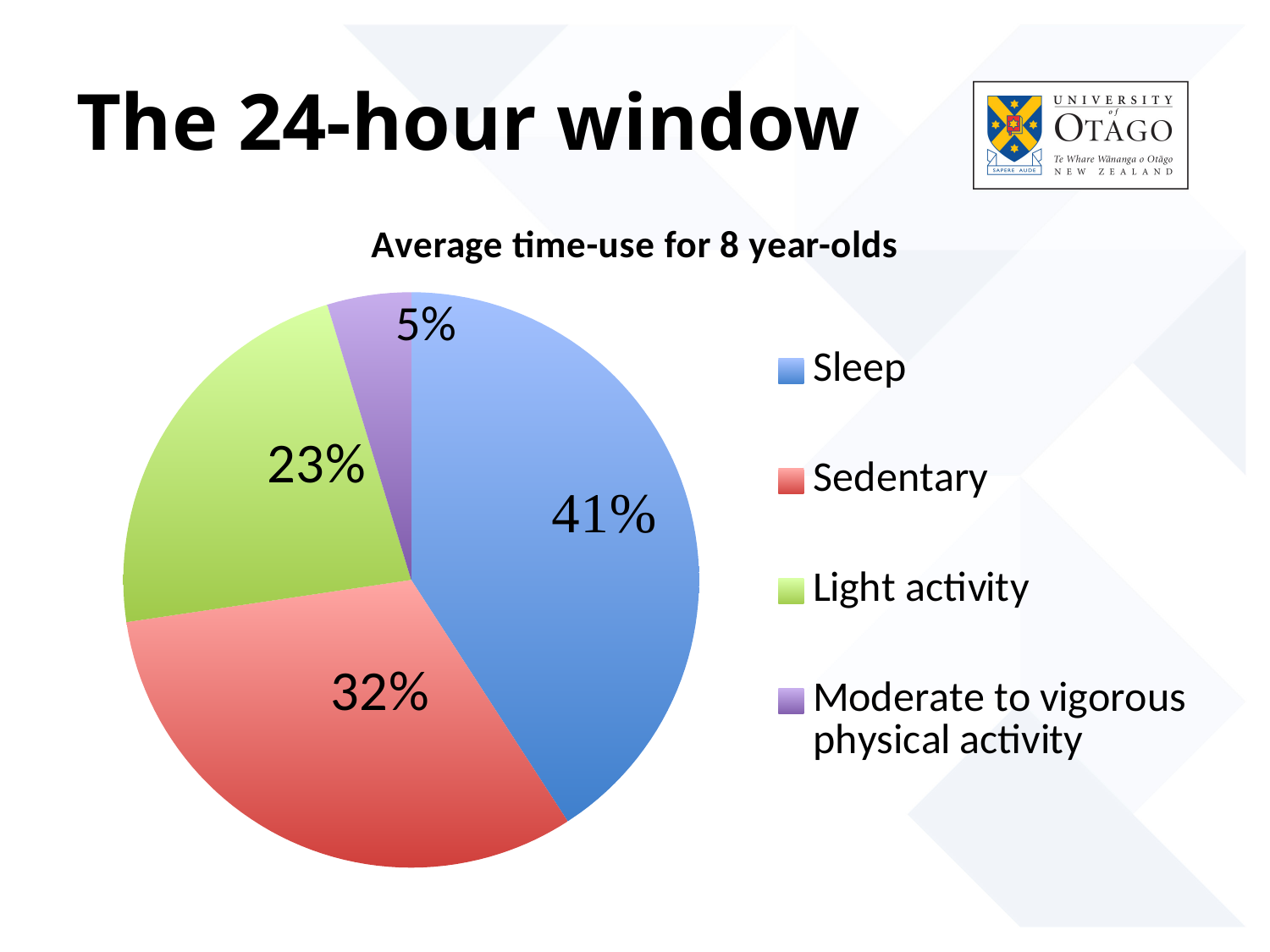
What is the title of the chart? Average time-use for 8 year-olds What share of the pie does Sedentary take? 32% Which category has the largest slice of the pie? Sleep Which is larger, the Sedentary slice or the Light activity slice? Sedentary What kind of chart is shown on the slide? Pie chart What is the difference in percentage points between Sleep and Sedentary? 9 What share of the pie does Light activity take? 23% What share of the pie does Moderate to vigorous physical activity take? 5% What is the difference in percentage points between Light activity and Moderate to vigorous physical activity? 18 How many categories does the pie chart show? 4 Which category has the smallest slice of the pie? Moderate to vigorous physical activity